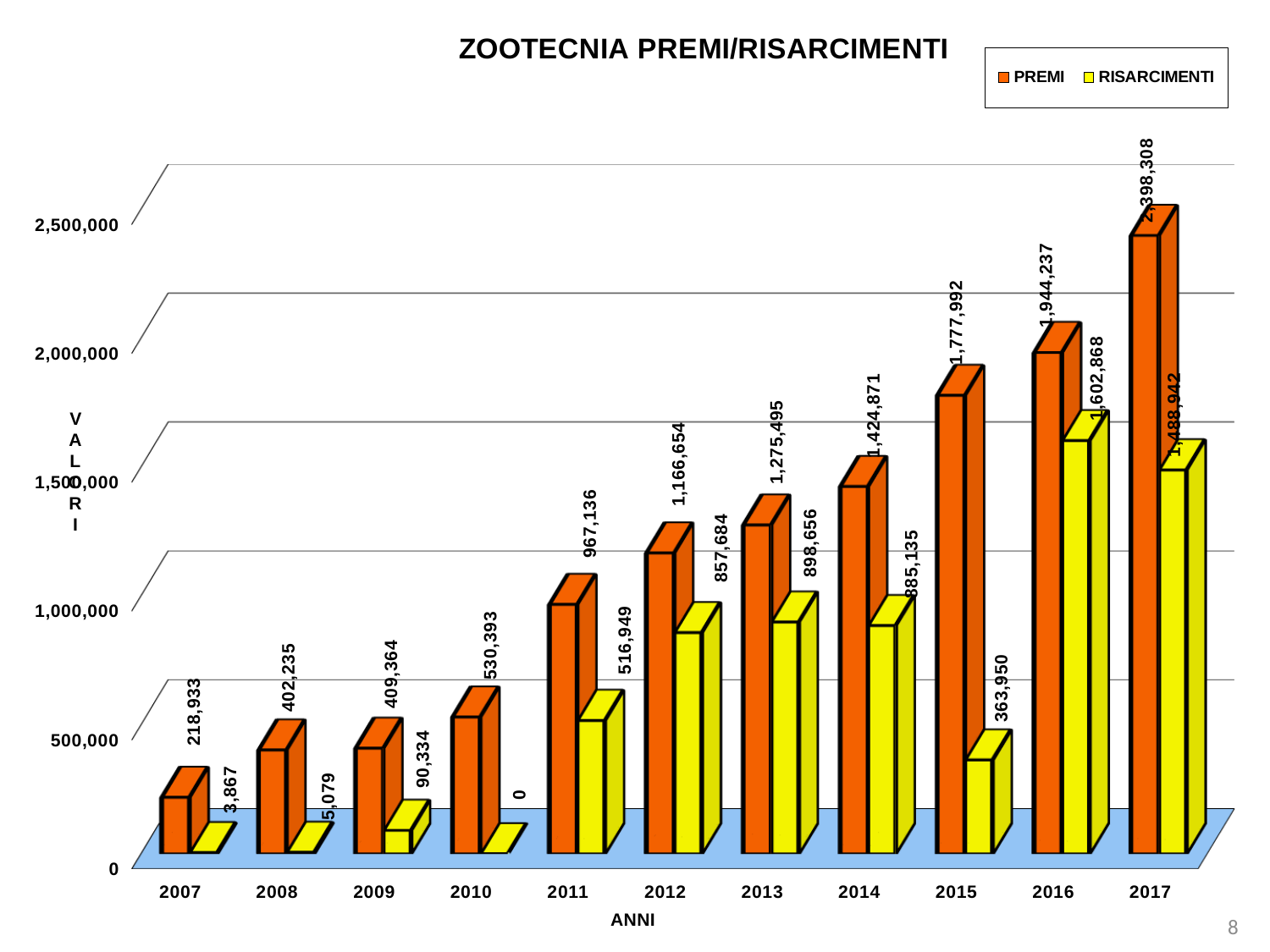
How many years are shown on the x axis? 11 Is the PREMI value for 2016 greater or less than 2,000,000? less What is the PREMI value for 2011? 967,136 What is the difference between PREMI and RISARCIMENTI in 2017? 909,366 How many series does the legend list? 2 What kind of chart is shown on the slide? bar chart What is the RISARCIMENTI value for 2016? 1,602,868 Which is larger in 2015, PREMI or RISARCIMENTI? PREMI Which year has the lowest PREMI value? 2007 What is the RISARCIMENTI value for 2010? 0 Which year has the highest PREMI value? 2017 Do the PREMI values rise or fall from 2007 to 2017? rise